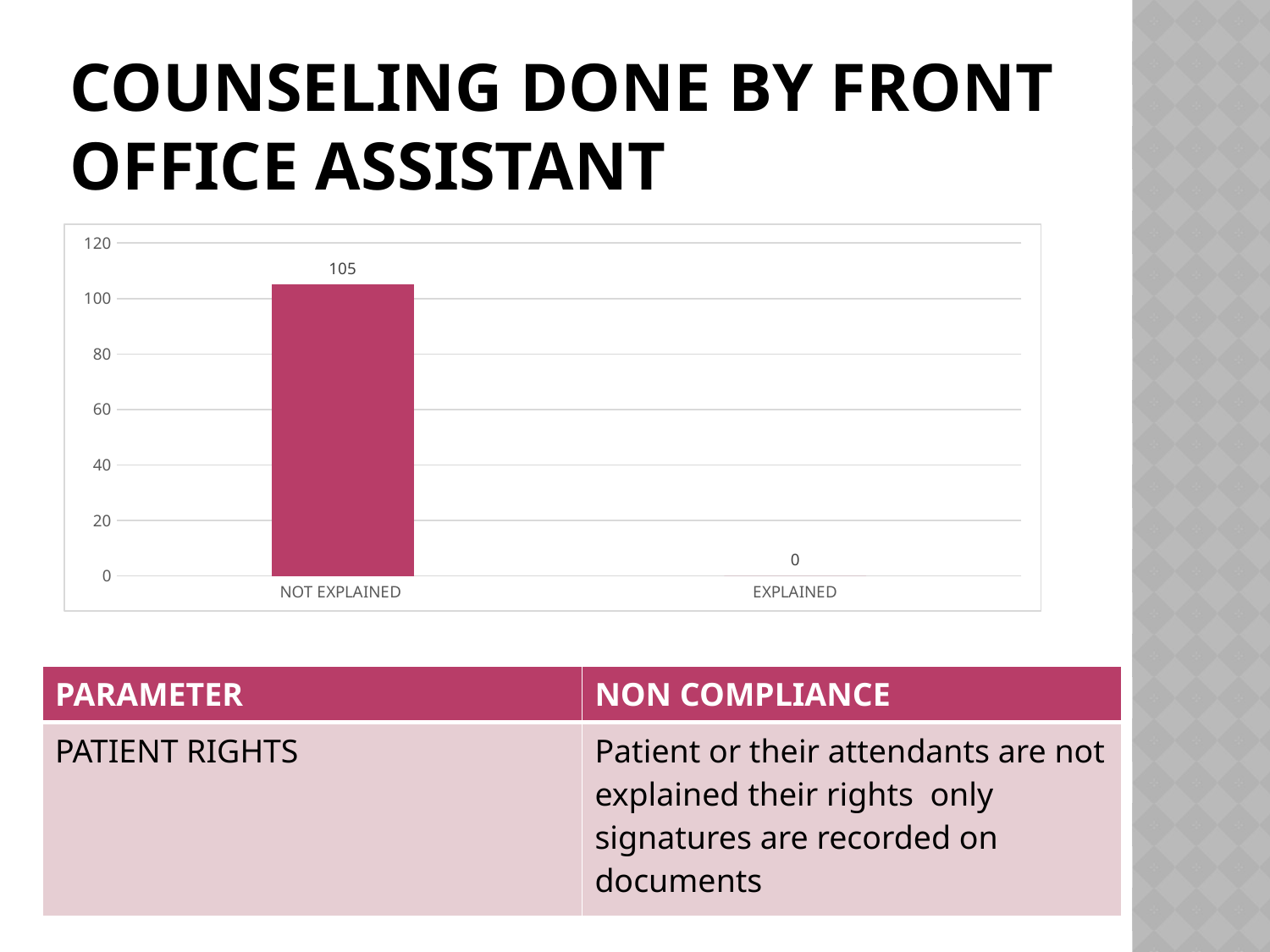
What is the difference between the values for NOT EXPLAINED and EXPLAINED? 105 Is the value for NOT EXPLAINED greater or less than 100? greater Which category has the highest value? NOT EXPLAINED How many categories are shown on the x axis? 2 What is the value for EXPLAINED? 0 Which is larger, the value for NOT EXPLAINED or the value for EXPLAINED? NOT EXPLAINED What colour is the bar for NOT EXPLAINED? pink/magenta Do the values rise or fall from NOT EXPLAINED to EXPLAINED? fall What is the value for NOT EXPLAINED? 105 Which category has the lowest value? EXPLAINED What is the highest value shown on the y axis? 120 What kind of chart is shown on the slide? bar chart